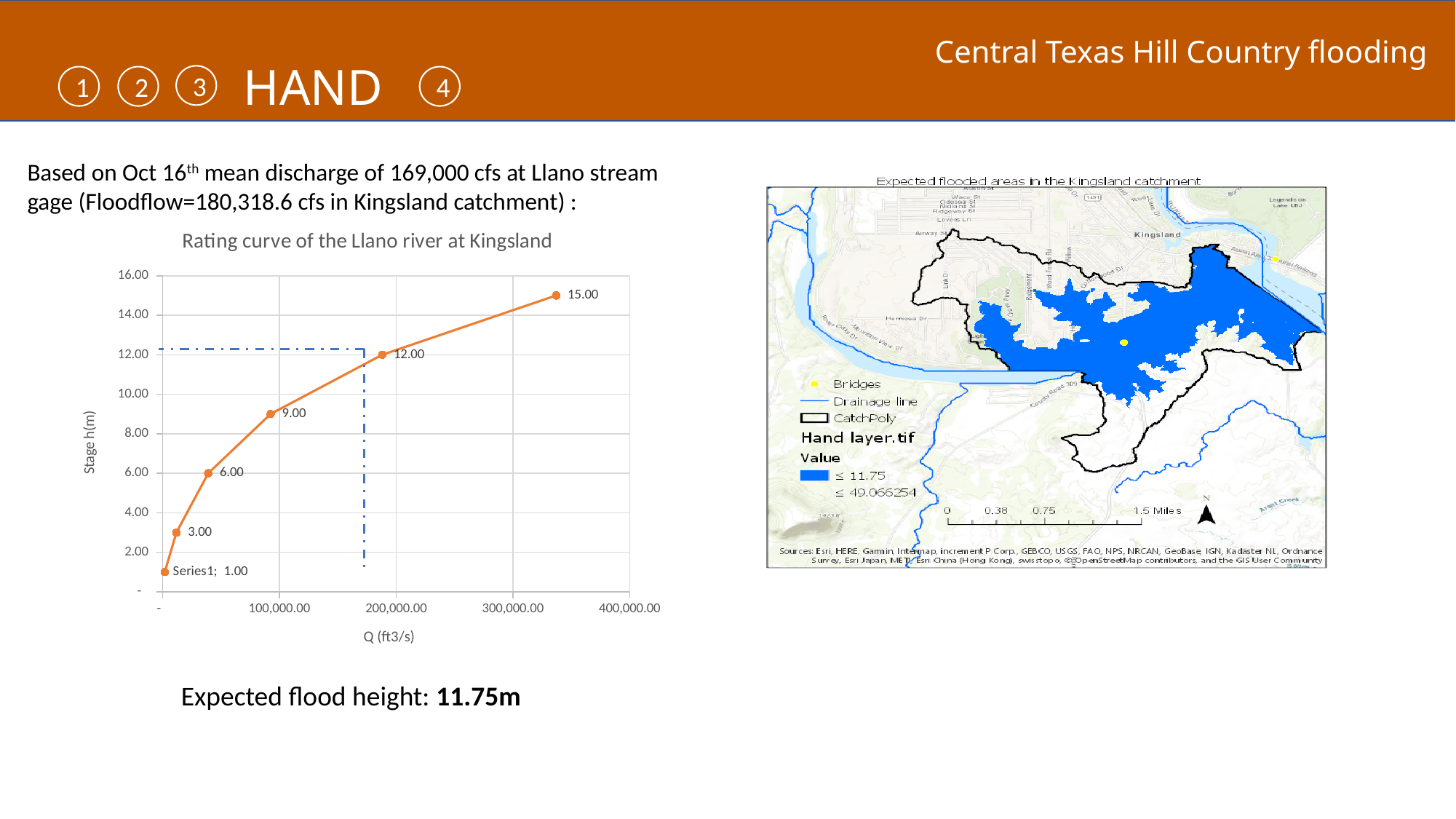
On the rating curve chart, is the discharge Q for the point labelled 15.00 greater or less than 300,000.00? greater What is the difference between the highest and lowest labelled stage values on the rating curve chart? 14.00 What is the lowest stage value labelled on the rating curve chart? 1.00 What is the label of the x axis on the rating curve chart? Q (ft3/s) Do the stage values on the rating curve rise or fall as discharge Q increases along the x axis? rise What is the title of the chart on the slide? Rating curve of the Llano river at Kingsland On the rating curve chart, which labelled point has the larger stage value: the one labelled 9.00 or the one labelled 3.00? 9.00 What is the highest stage value labelled on the rating curve chart? 15.00 On the rating curve chart, is the discharge Q for the point labelled 6.00 greater or less than 100,000.00? less How many data points are plotted on the rating curve chart? 6 What type of chart is the 'Rating curve of the Llano river at Kingsland'? line chart On the rating curve chart, is the discharge Q for the point labelled 12.00 greater or less than 200,000.00? less